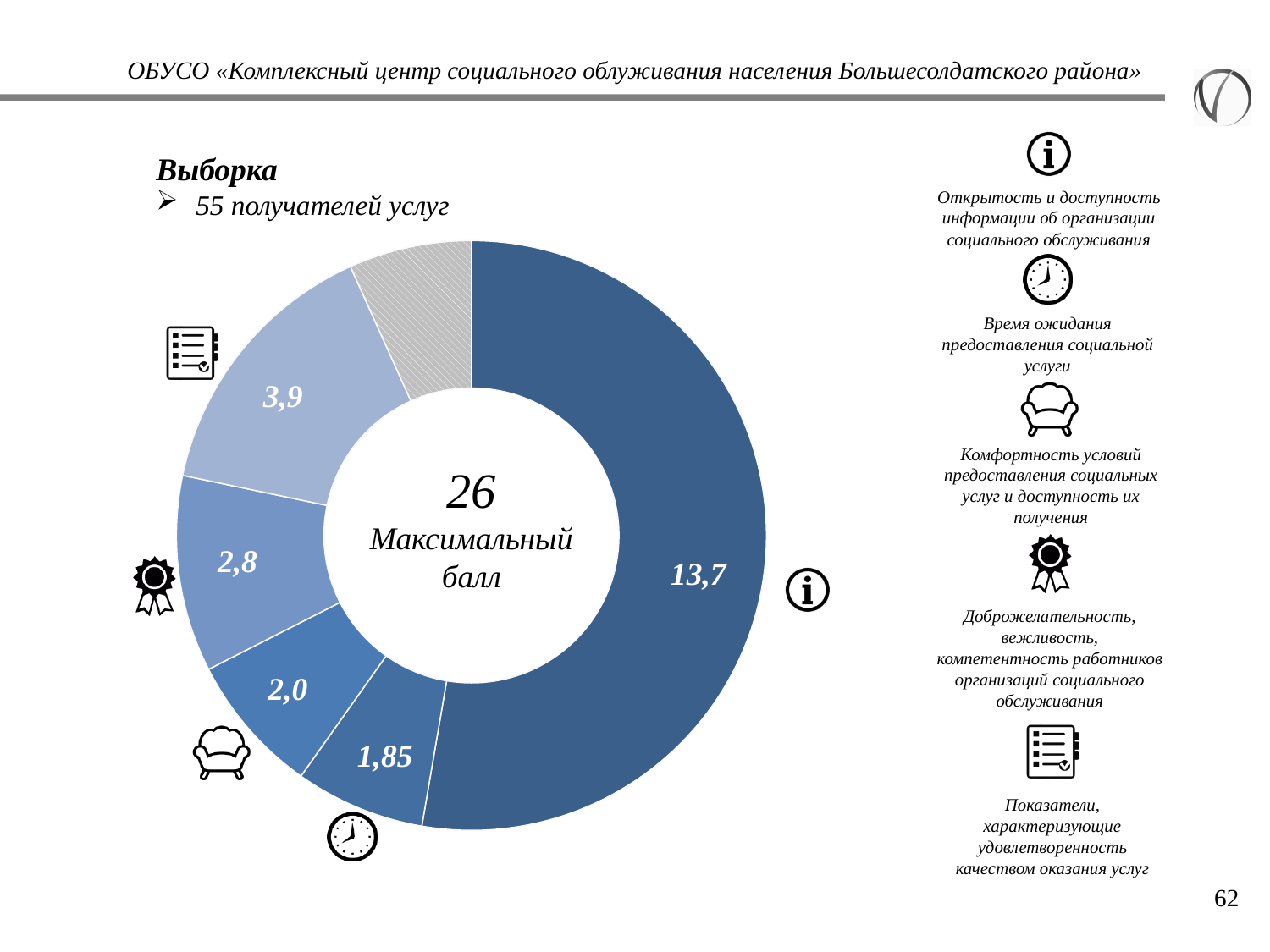
What value is shown for the slice marked with the checklist icon (Показатели, характеризующие удовлетворенность качеством оказания услуг)? 3,9 What value is shown for the slice marked with the armchair icon (Комфортность условий предоставления социальных услуг)? 2,0 How many slices of the chart have a printed data label? 5 What number is printed in the centre of the donut chart, and what does it represent? 26, Максимальный балл What value is shown for the slice marked with the medal icon (Доброжелательность, вежливость, компетентность работников)? 2,8 What is the difference between the largest labeled slice (13,7) and the checklist-icon slice (3,9)? 9,8 What is the difference between the medal-icon slice (2,8) and the armchair-icon slice (2,0)? 0,8 What value is shown for the slice marked with the clock icon (Время ожидания предоставления социальной услуги)? 1,85 What value is shown for the slice marked with the information icon (Открытость и доступность информации об организации социального обслуживания)? 13,7 Which slice is larger: the one with the medal icon or the one with the armchair icon? the medal icon slice (2,8) What kind of chart is shown on the slide? donut (pie) chart Which labeled slice of the chart has the highest value? Открытость и доступность информации (13,7)